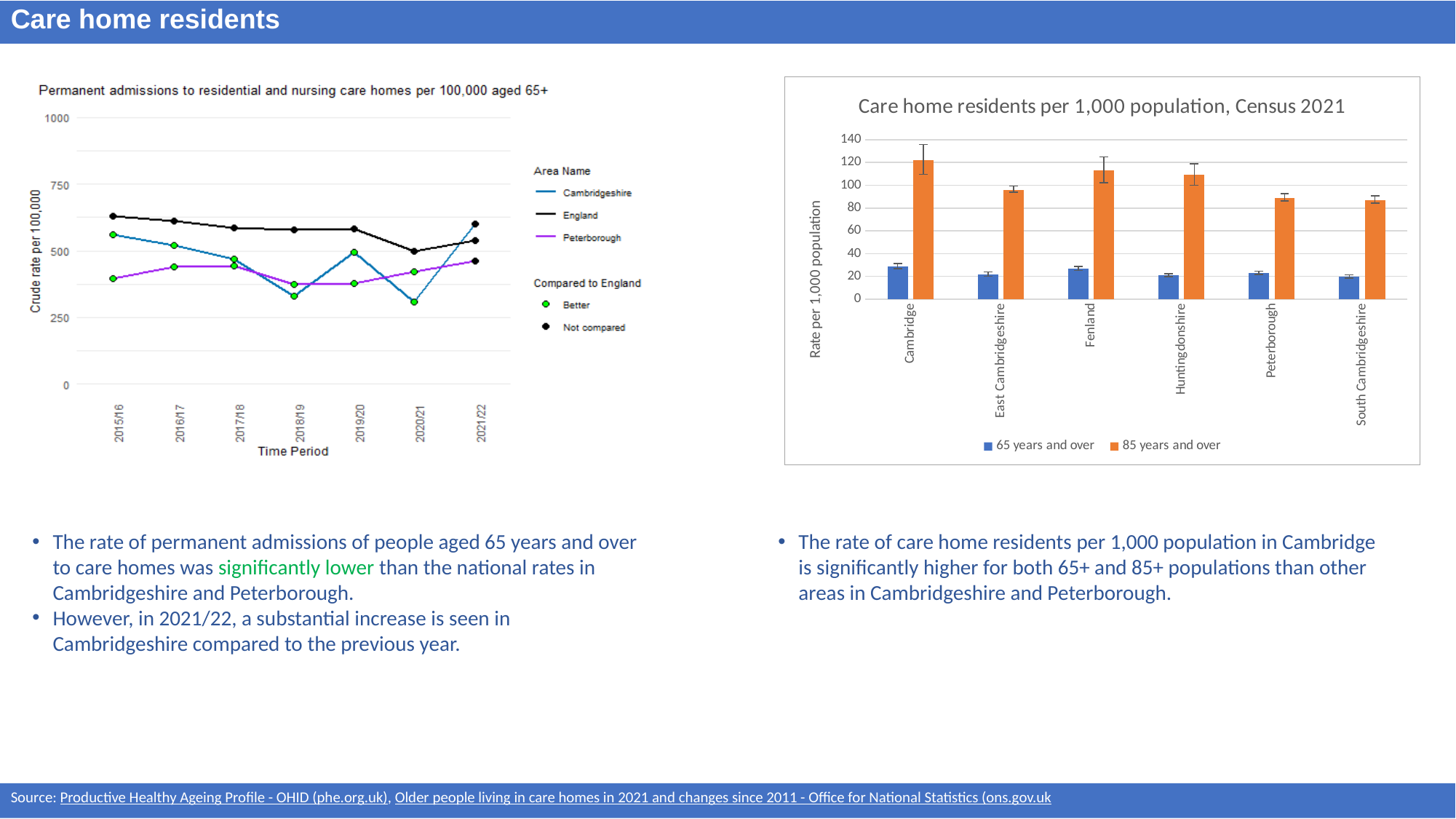
What type of chart is the left chart, 'Permanent admissions to residential and nursing care homes per 100,000 aged 65+'? line chart In the left chart, how many time periods are shown on the x axis? 7 In the right chart, is the value for East Cambridgeshire for 85 years and over greater or less than 100? less In the right chart, which area has the highest rate for 85 years and over? Cambridge In the left chart, is the value for England in 2015/16 greater or less than 500? greater In the left chart, is the value for Cambridgeshire in 2020/21 greater or less than 500? less In the left chart, which area has the highest crude rate in 2015/16? England In the right chart, how many areas are shown on the x axis? 6 What type of chart is the right chart, 'Care home residents per 1,000 population, Census 2021'? bar chart In the left chart, which area has the lowest crude rate in 2020/21? Cambridgeshire In the right chart, how many series does the legend list? 2 In the left chart, how many area series are listed under 'Area Name' in the legend? 3